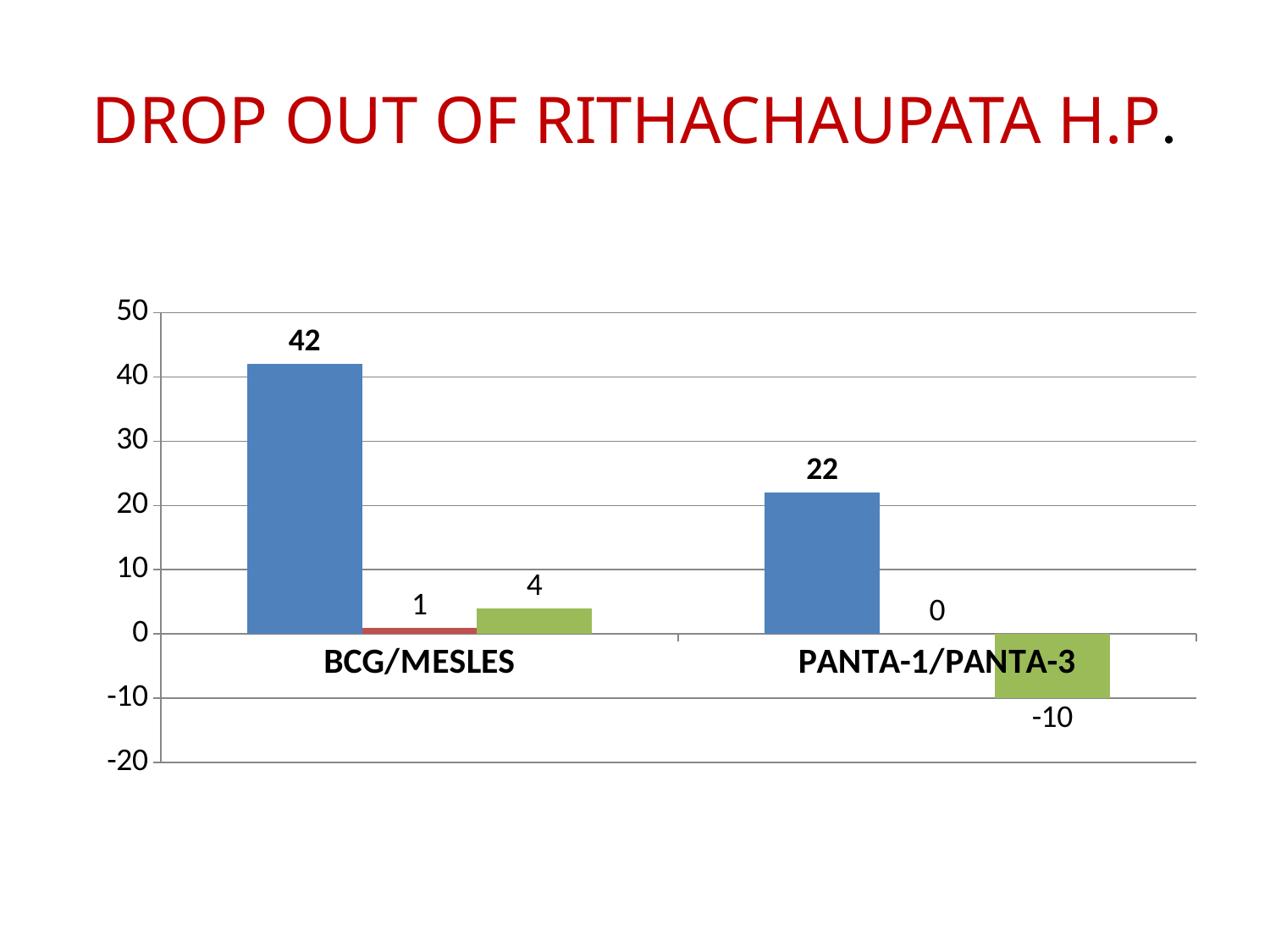
What is the value of the red bar for BCG/MESLES? 1 Which is larger, the green bar for BCG/MESLES or the green bar for PANTA-1/PANTA-3? BCG/MESLES What is the value of the green bar for BCG/MESLES? 4 Is the blue bar value for BCG/MESLES greater or less than 40? greater How many categories are shown on the x axis? 2 What is the difference between the blue bar values for BCG/MESLES and PANTA-1/PANTA-3? 20 What is the value of the blue bar for PANTA-1/PANTA-3? 22 What is the value of the blue bar for BCG/MESLES? 42 What kind of chart is shown on the slide? bar chart What is the title of the slide? DROP OUT OF RITHACHAUPATA H.P. What is the value of the green bar for PANTA-1/PANTA-3? -10 Which category has the highest blue bar? BCG/MESLES